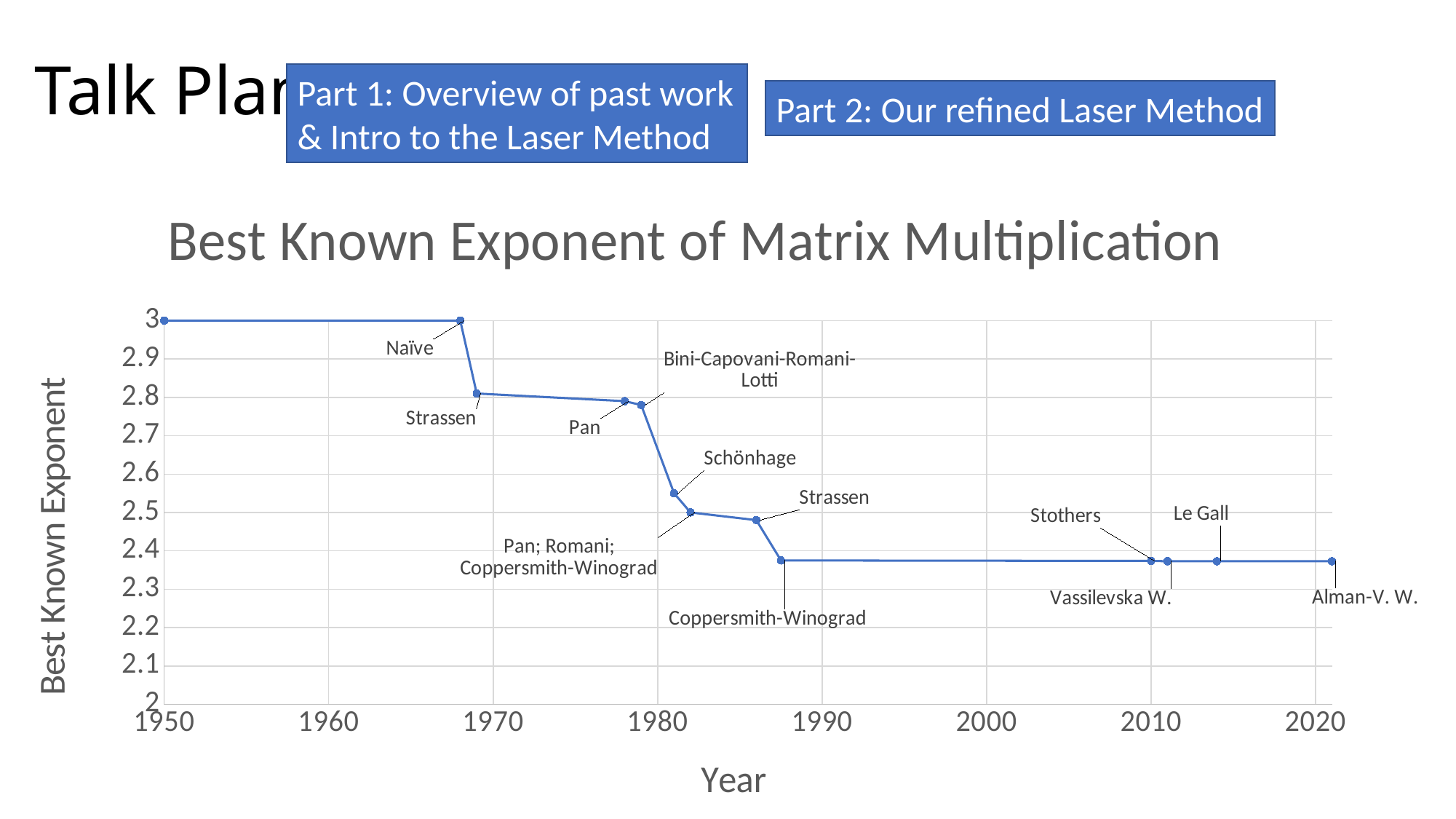
What kind of chart is shown on the slide? line chart How many data points are plotted on the line? 13 Is the value for the point labelled Coppersmith-Winograd greater or less than 2.4? less Is the value for the point labelled Le Gall greater or less than 2.4? less What is the value of the point labelled Naïve? 3 Which has the larger value, the point labelled Schönhage or the point labelled Coppersmith-Winograd? Schönhage What is the label of the x axis of the chart? Year Is the value for the point labelled Schönhage greater or less than 2.5? greater What is the title of the chart? Best Known Exponent of Matrix Multiplication Do the plotted values rise or fall as the year increases along the x axis? fall Which labelled point has the highest value on the chart? Naïve